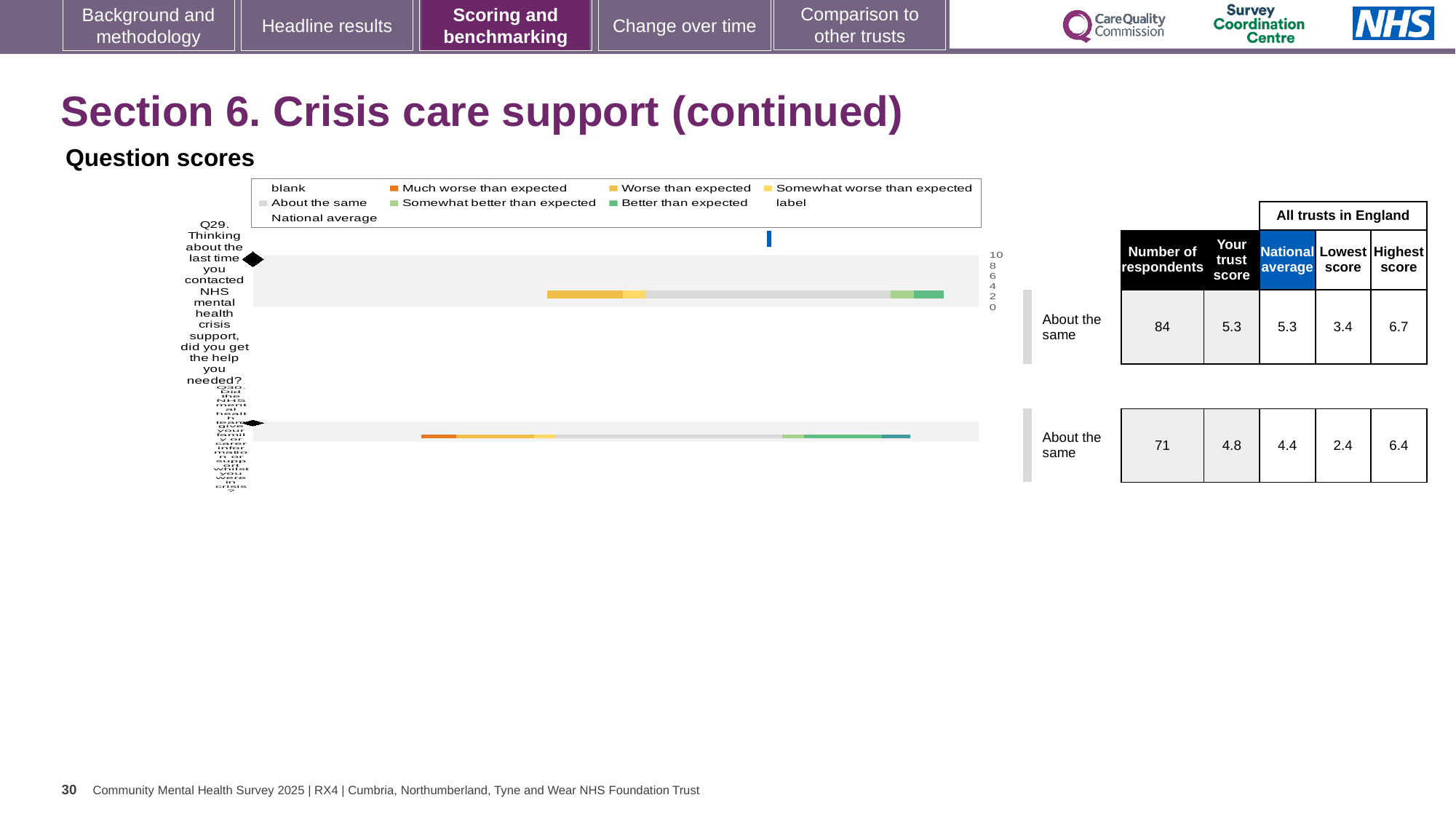
What kind of chart is used to show the question scores on this slide? bar chart What is the national average score for Q30? 4.4 How many respondents answered Q29? 84 What is the trust score for Q30? 4.8 Which question has the higher trust score, Q29 or Q30? Q29 What is the trust score for Q29 (Thinking about the last time you contacted NHS mental health crisis support, did you get the help you needed?)? 5.3 How many questions (bars) are plotted in the question scores chart? 2 What colour is the 'Much worse than expected' entry in the chart legend? orange What is the national average score for Q29? 5.3 What is the highest score among all trusts in England for Q30? 6.4 What is the difference between the trust scores for Q29 and Q30? 0.5 What is the highest tick value shown on the score axis of the chart? 10